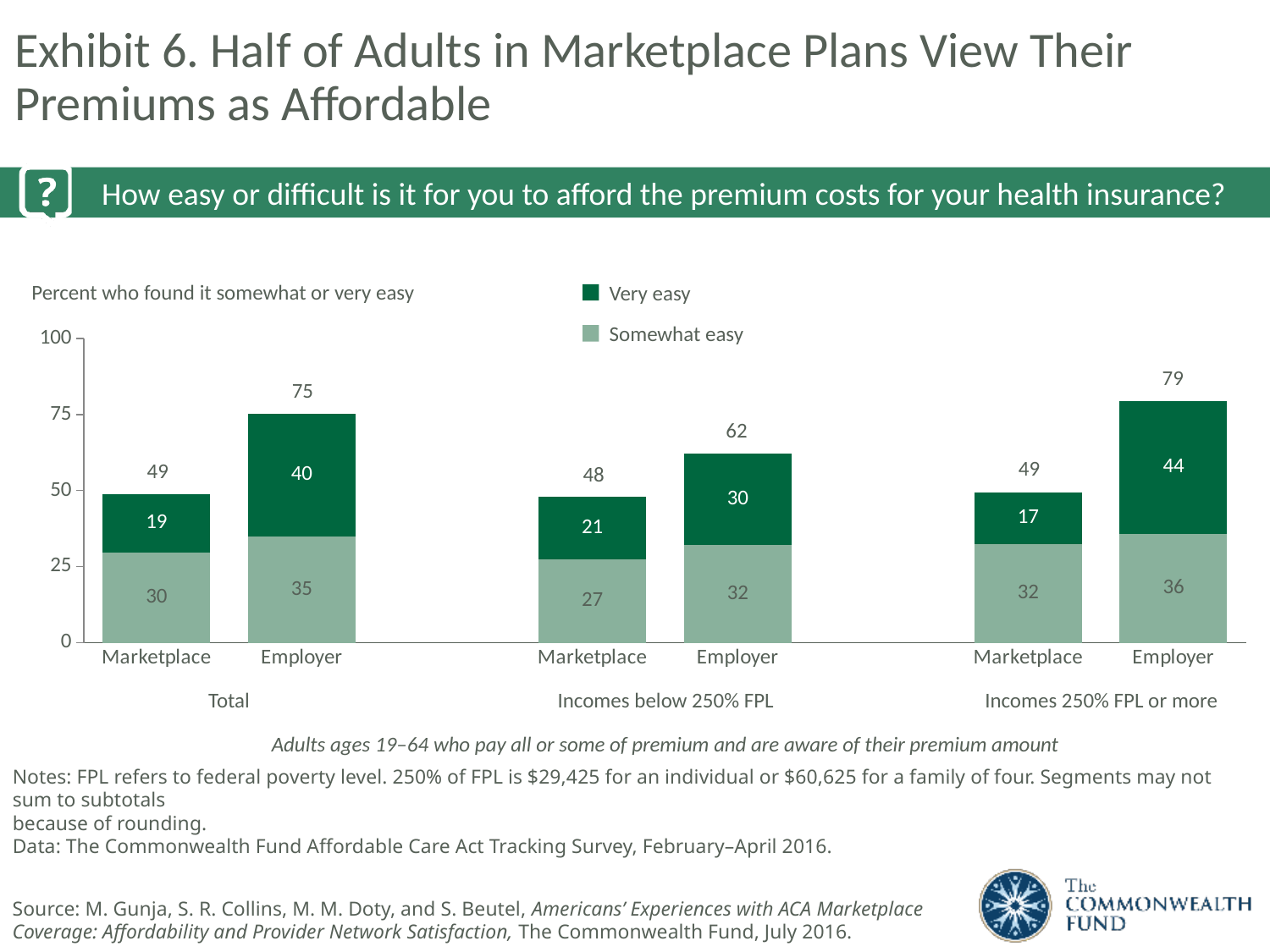
What is the 'Very easy' value for Employer in the Total group? 40 Which bar has the highest total value? Employer, Incomes 250% FPL or more What is the 'Somewhat easy' value for Marketplace in the Incomes below 250% FPL group? 27 Is the total for Marketplace in the Incomes 250% FPL or more group greater or less than 50? less In the Incomes below 250% FPL group, which is larger: the 'Very easy' value for Employer or for Marketplace? Employer What kind of chart is shown on the slide? Stacked bar chart Which bar has the lowest total value? Marketplace, Incomes below 250% FPL How many bars are plotted in the chart? 6 What is the total printed above the Employer bar in the Incomes 250% FPL or more group? 79 Which legend entry is shown in the darker green colour? Very easy How many series does the legend list? 2 What is the difference between the Employer and Marketplace totals in the Total group? 26